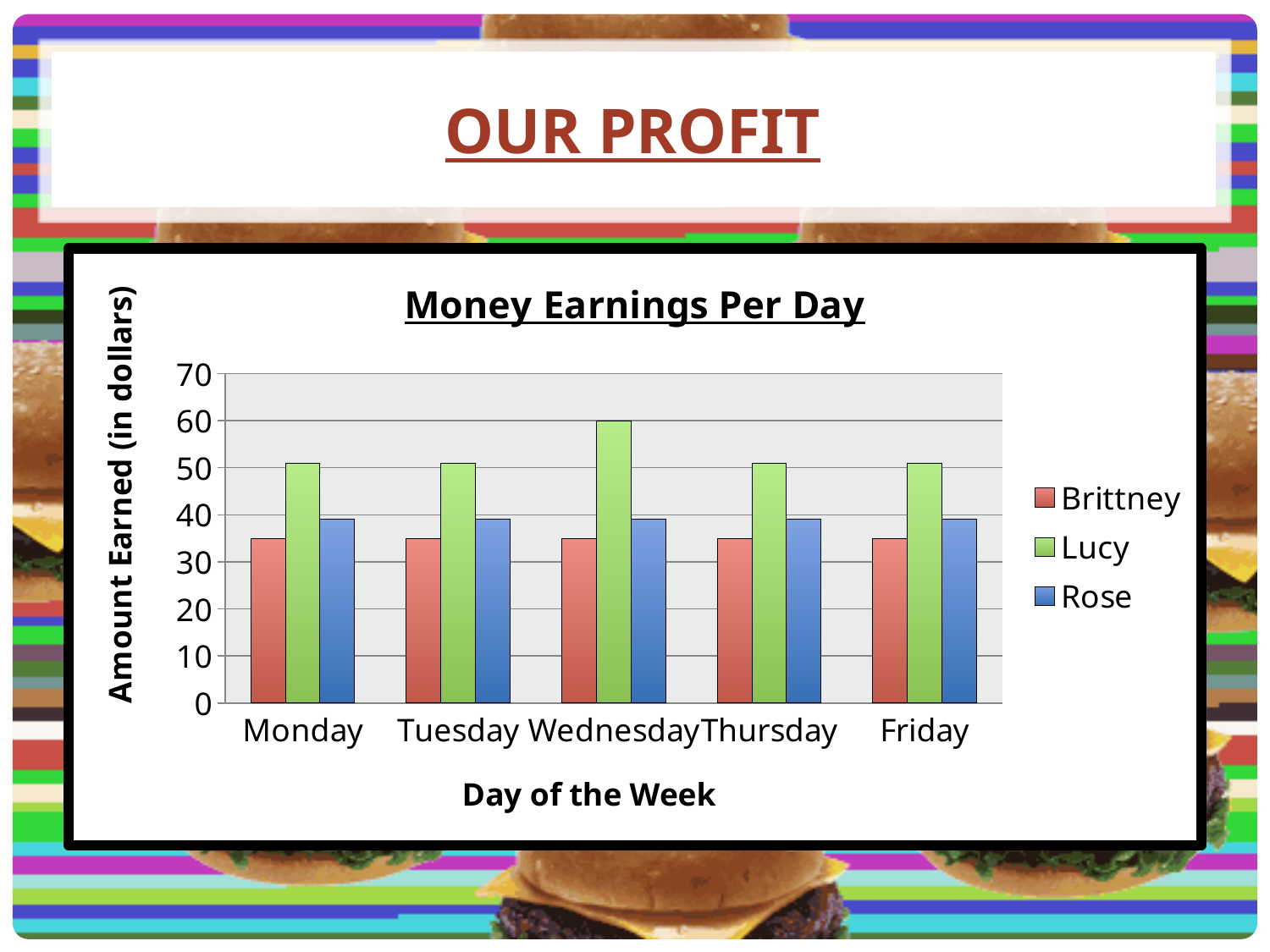
How many series does the legend list? 3 What kind of chart is shown on the slide? bar chart Which is larger on Thursday, the value for Rose or the value for Brittney? Rose Which series has the highest bar on Wednesday? Lucy Which series has the lowest bar on Monday? Brittney What is the title of the chart? Money Earnings Per Day How many days of the week are shown on the x axis? 5 What is the value for Lucy on Wednesday? 60 On which day does Lucy have her highest value? Wednesday Is the value for Brittney on Friday greater or less than 40? less What is the label of the vertical axis? Amount Earned (in dollars)